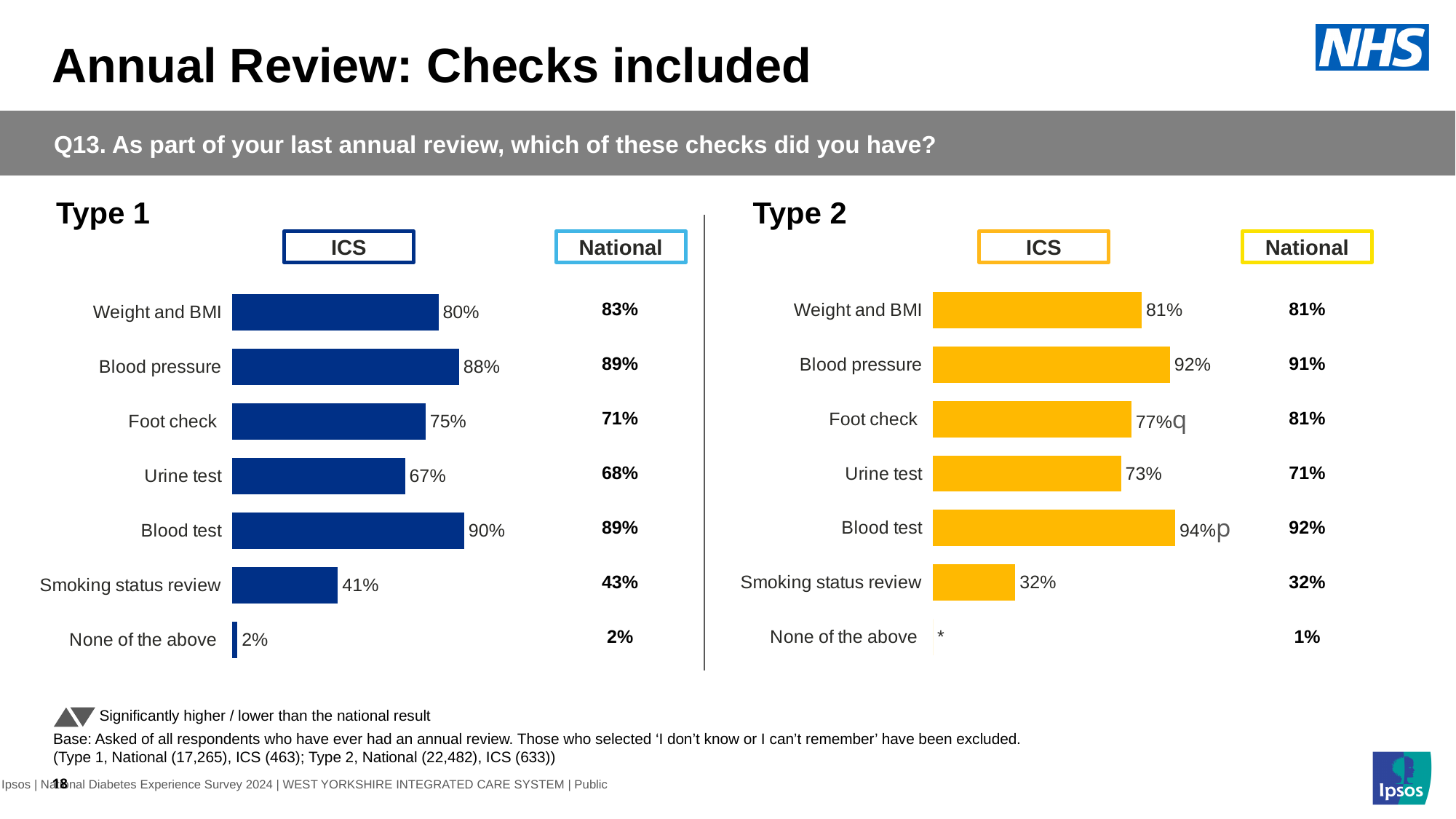
In the Type 2 chart, which is larger: the ICS value for Blood pressure or the ICS value for Weight and BMI? Blood pressure In the Type 2 chart, what is the difference between the ICS and National values for Foot check? 4 percentage points In the Type 2 chart, what is the ICS value for Foot check? 77% In the Type 1 chart, is the ICS value for Foot check higher or lower than the National value? higher In the Type 2 chart, what is the National value for None of the above? 1% How many categories are shown in the Type 1 chart? 7 In the Type 1 chart, what is the ICS value for Blood pressure? 88% In the Type 1 chart, which category has the lowest ICS value? None of the above In the Type 1 chart, what is the National value for Smoking status review? 43% In the Type 2 chart, which category has the highest ICS value? Blood test In the Type 1 chart, what is the difference between the ICS values for Blood test and Urine test? 23 percentage points What kind of chart is used for the Type 2 ICS results? bar chart